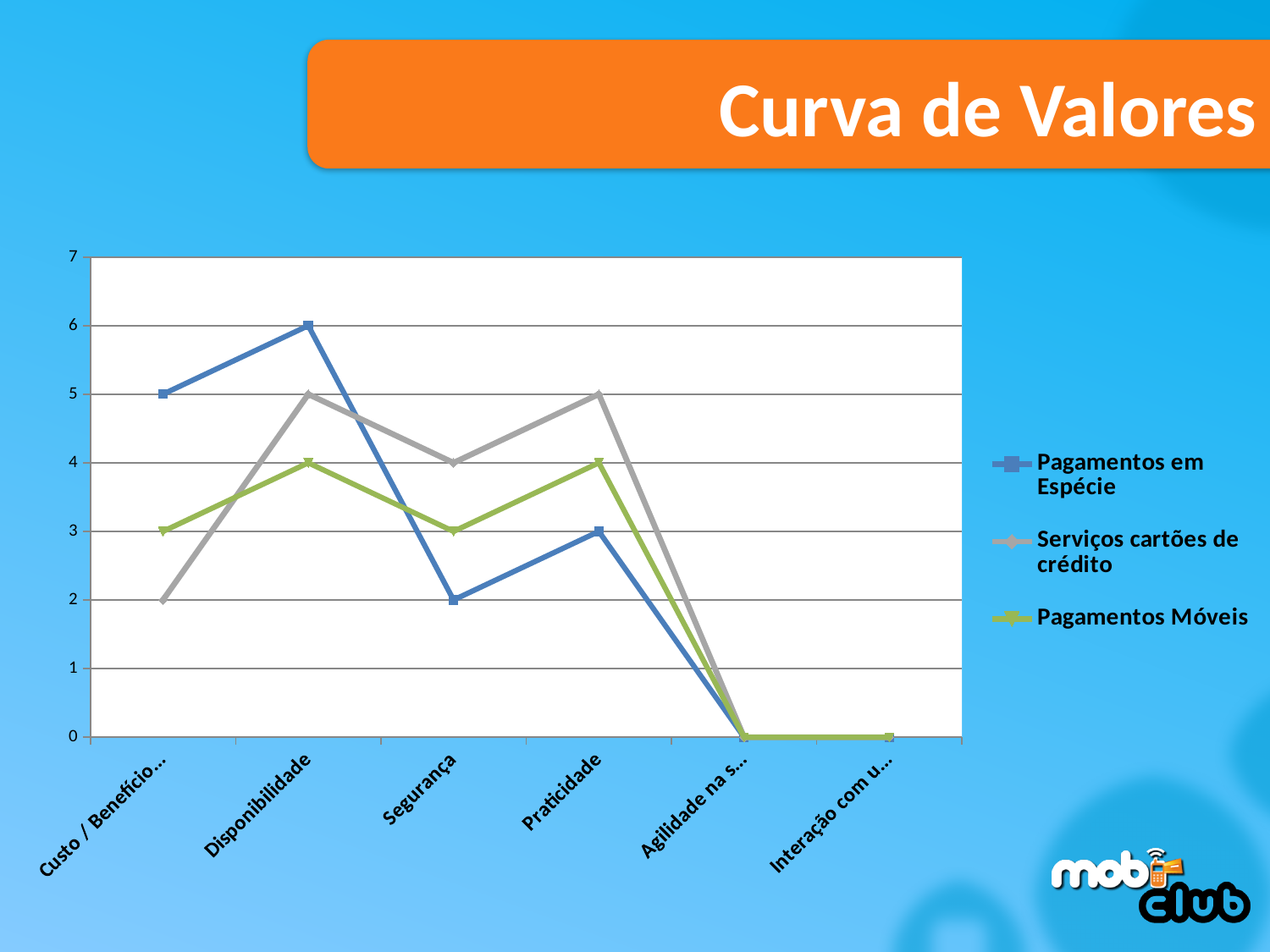
What is the value for Serviços cartões de crédito at Segurança? 4 What is the value for Pagamentos Móveis at Praticidade? 4 At Disponibilidade, which is larger: Pagamentos em Espécie or Pagamentos Móveis? Pagamentos em Espécie What is the value for Pagamentos em Espécie at Segurança? 2 Which series has the lowest value at Segurança? Pagamentos em Espécie At which category does Pagamentos em Espécie reach its highest value? Disponibilidade What is the value for Pagamentos em Espécie at Disponibilidade? 6 What kind of chart is shown on the slide? line chart How many categories are shown on the x axis? 6 How many series does the legend list? 3 What is the title of the slide containing the chart? Curva de Valores What is the difference between Serviços cartões de crédito and Pagamentos Móveis at Praticidade? 1